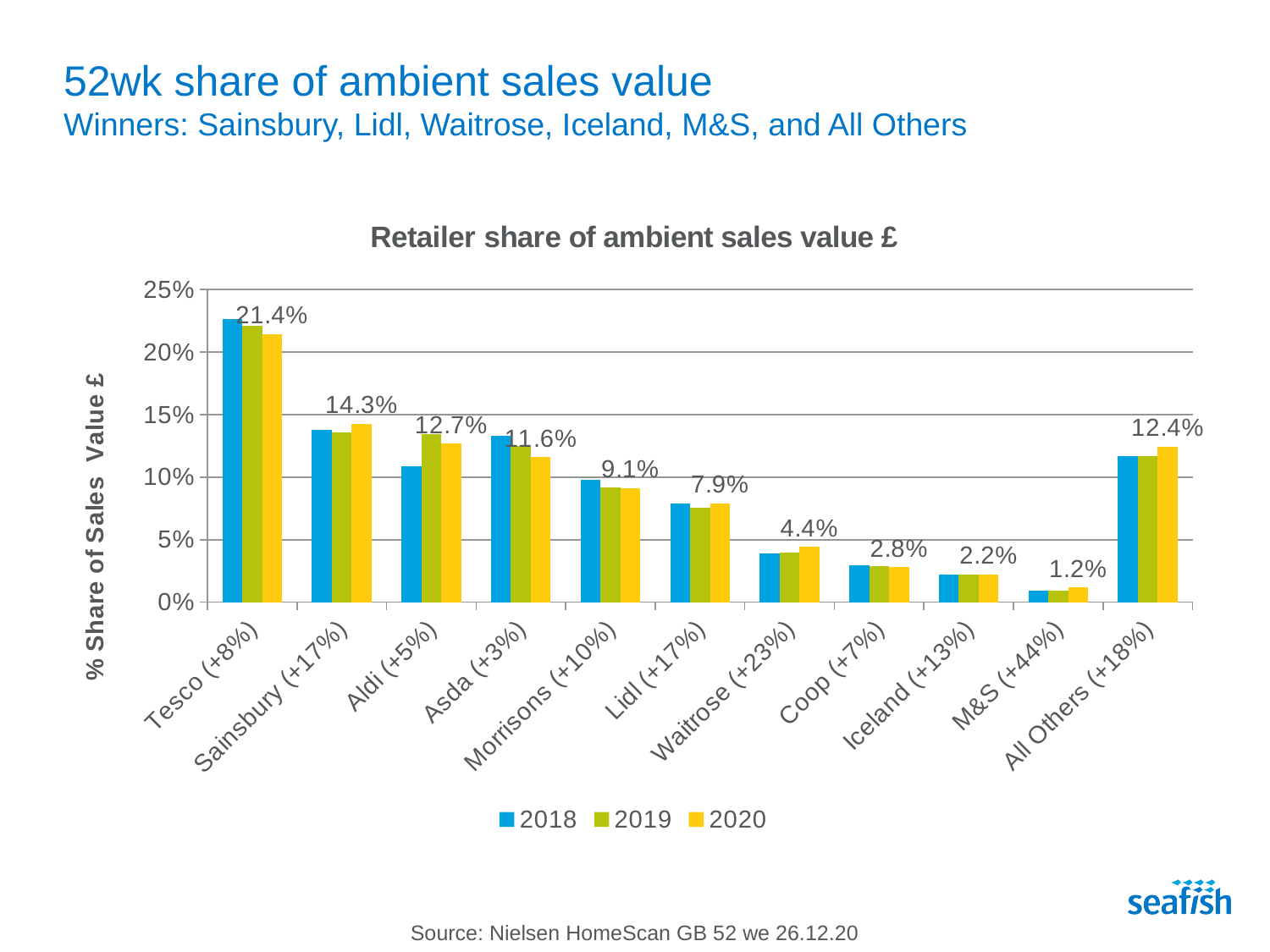
What is the 2020 value for M&S (+44%)? 1.2% What is the difference between the 2020 values for Tesco (+8%) and Sainsbury (+17%)? 7.1% Which retailer has the highest 2020 share of ambient sales value? Tesco (+8%) What kind of chart is shown on the slide? Bar chart What is the 2020 value for Sainsbury (+17%)? 14.3% Which is larger in 2020: Aldi (+5%) or Asda (+3%)? Aldi (+5%) What is the 2020 value for All Others (+18%)? 12.4% How many series does the legend list? 3 Which retailer has the lowest 2020 share of ambient sales value? M&S (+44%) Is the 2018 value for Tesco (+8%) greater or less than 20%? greater How many retailer categories are shown on the x axis? 11 What is the 2020 value for Tesco (+8%)? 21.4%